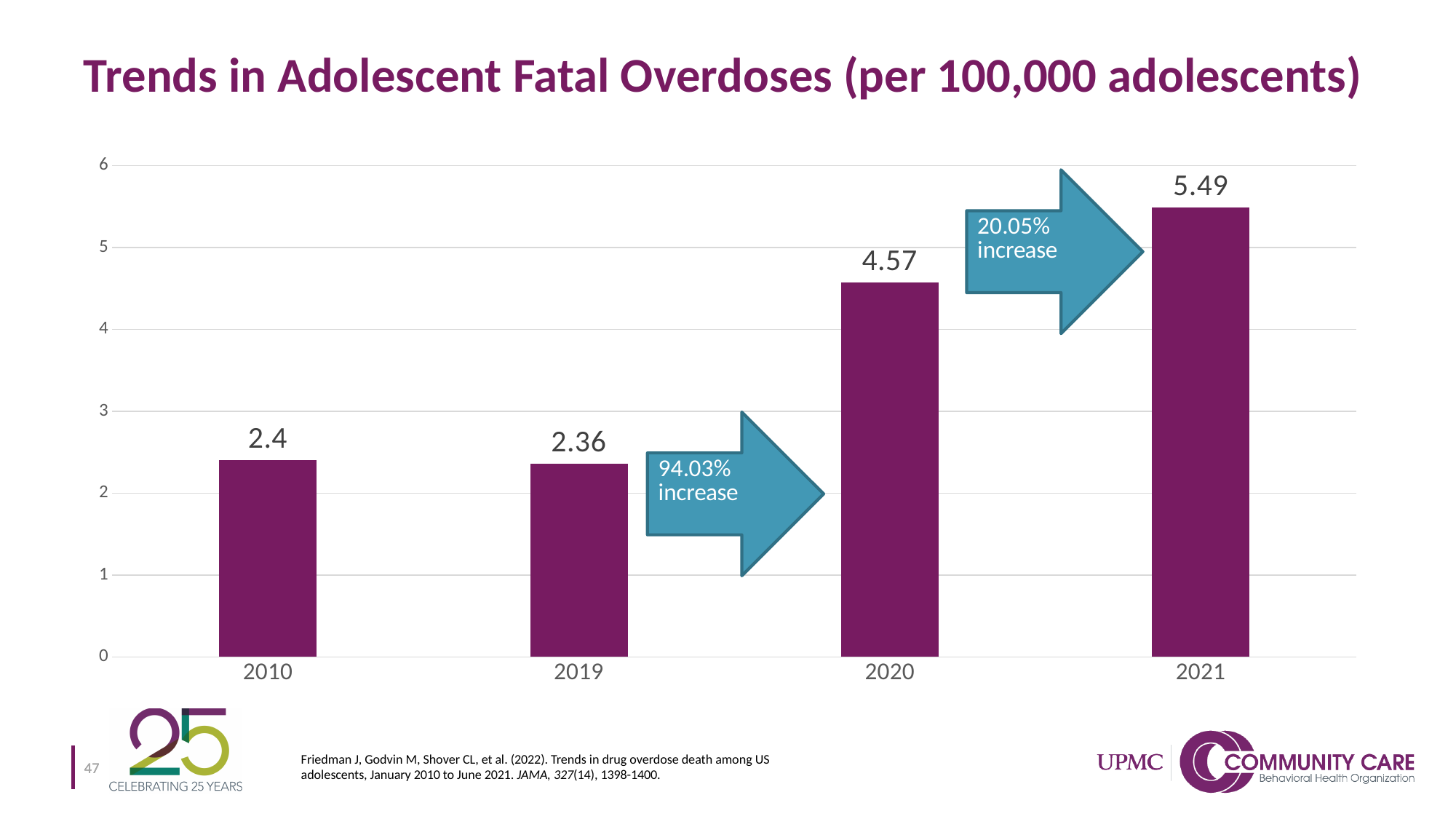
What is the difference between the values for 2021 and 2020? 0.92 Which year has the highest value? 2021 What is the value for 2020? 4.57 What is the value for 2021? 5.49 What is the difference between the values for 2020 and 2019? 2.21 Which year has the lowest value? 2019 How many years are shown on the x axis? 4 What is the value for 2019? 2.36 What percentage increase does the arrow between 2019 and 2020 show? 94.03% increase What kind of chart is this? Bar chart What is the value for 2010? 2.4 Which is larger, the value for 2010 or the value for 2020? 2020